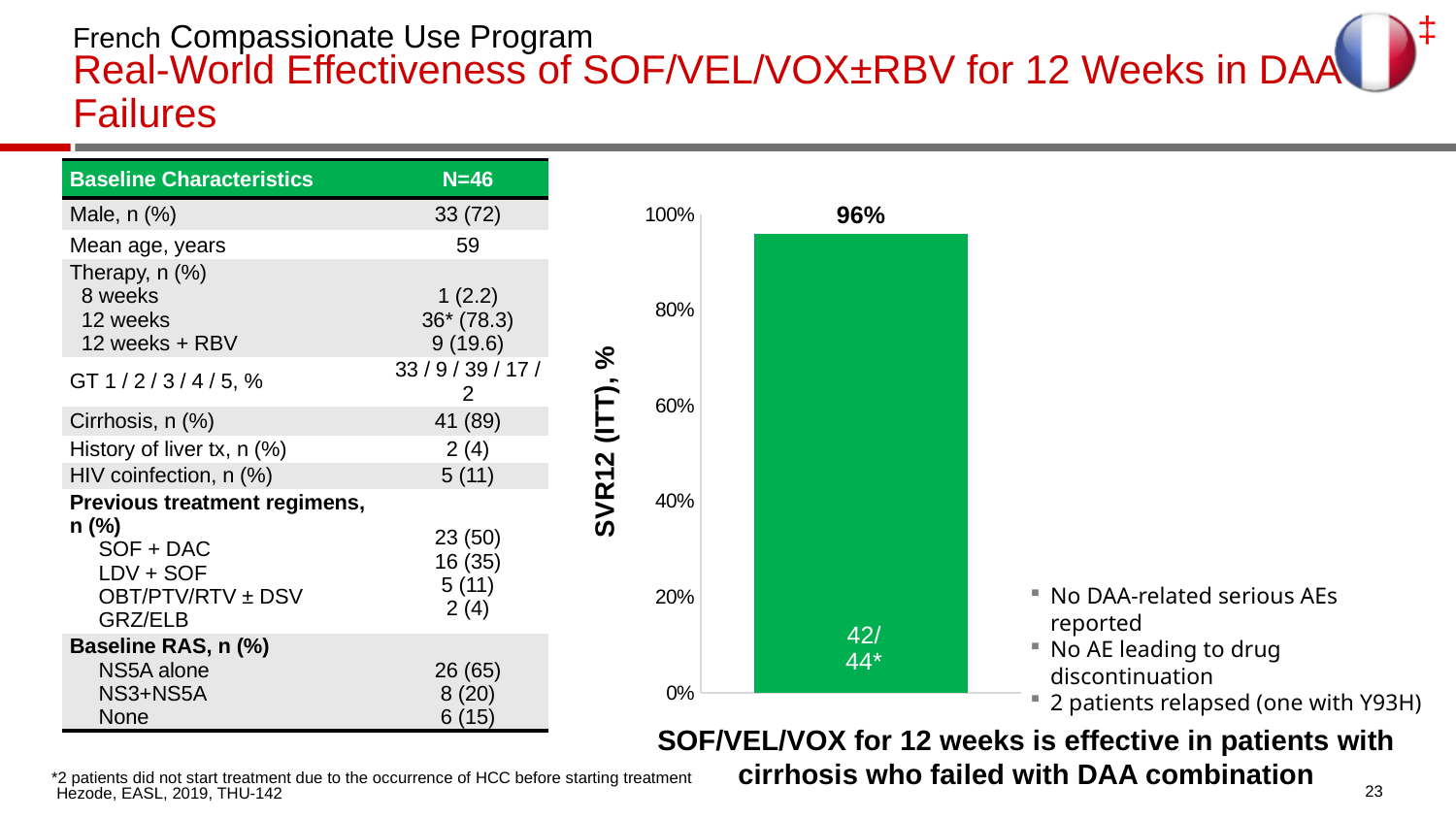
How many bars are plotted in the chart? 1 Is the SVR12 value shown in the chart greater or less than 80%? greater What kind of chart is shown on the slide? bar chart What is the label of the y axis of the chart? SVR12 (ITT), % What is the highest tick value shown on the y axis of the chart? 100% Is the SVR12 value shown in the chart greater or less than 100%? less What fraction of patients is printed inside the bar of the chart? 42/44* What SVR12 (ITT) value is shown on the bar in the chart? 96%